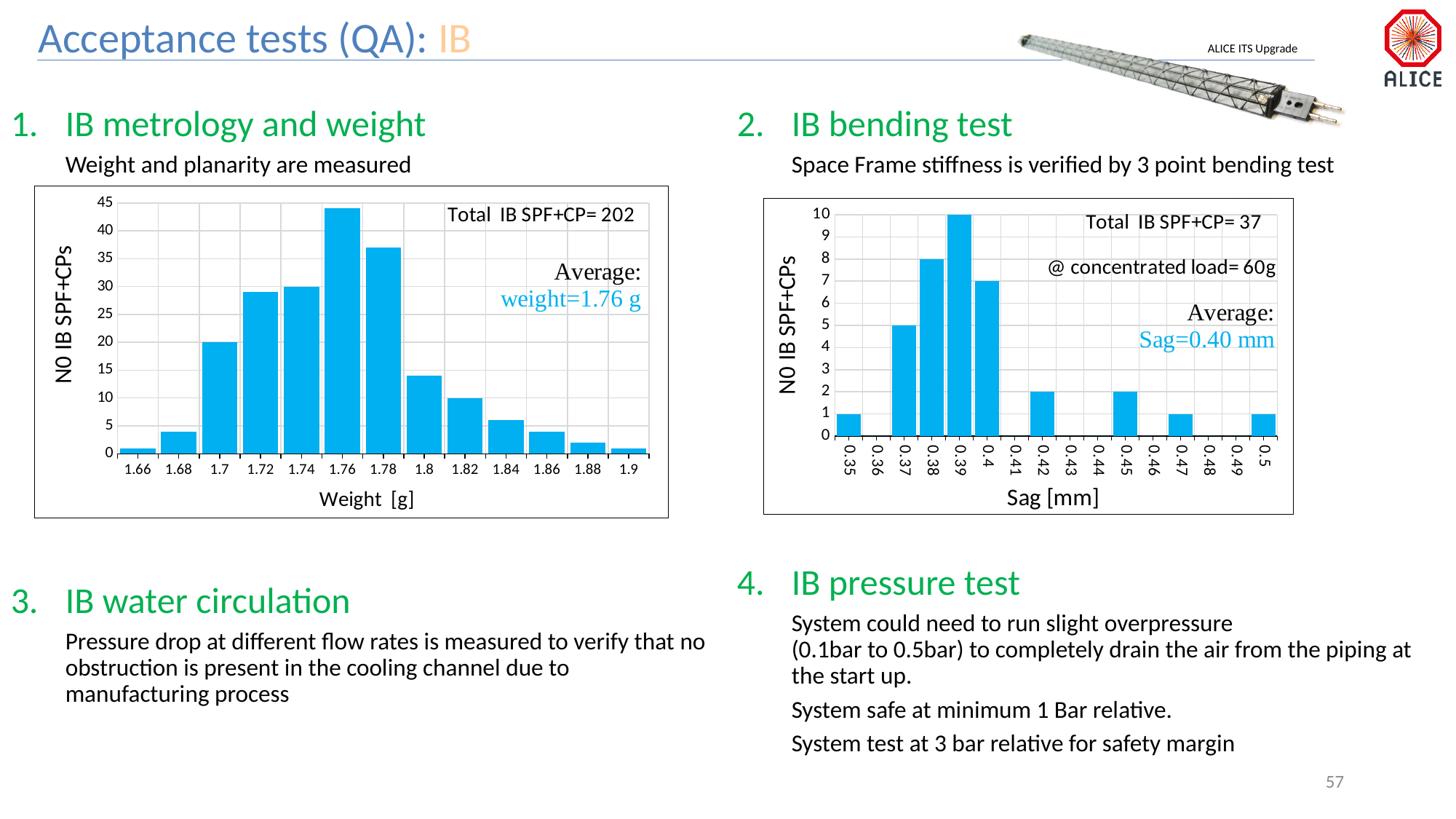
In the left chart (Weight [g]), is the value for the 1.76 bin greater or less than 40? greater In the right chart (Sag [mm]), which bin has more IB SPF+CPs, 0.37 or 0.42? 0.37 In the left chart (Weight [g]), how many weight bins are shown on the x axis? 13 In the left chart (Weight [g]), is the value for the 1.8 bin greater or less than 15? less In the right chart (Sag [mm]), what average sag is stated in the annotation? Sag=0.40 mm In the right chart (Sag [mm]), what is the difference between the 0.39 bin and the 0.4 bin? 3 In the left chart (Weight [g]), what is the total number of IB SPF+CP stated in the annotation? 202 What type of chart is the 'Weight [g]' chart on the left? bar chart In the left chart (Weight [g]), how many IB SPF+CPs are in the 1.7 g bin? 20 In the left chart (Weight [g]), which weight bin has the highest number of IB SPF+CPs? 1.76 In the right chart (Sag [mm]), how many IB SPF+CPs are in the 0.38 mm bin? 8 In the right chart (Sag [mm]), which sag bin has the highest number of IB SPF+CPs? 0.39